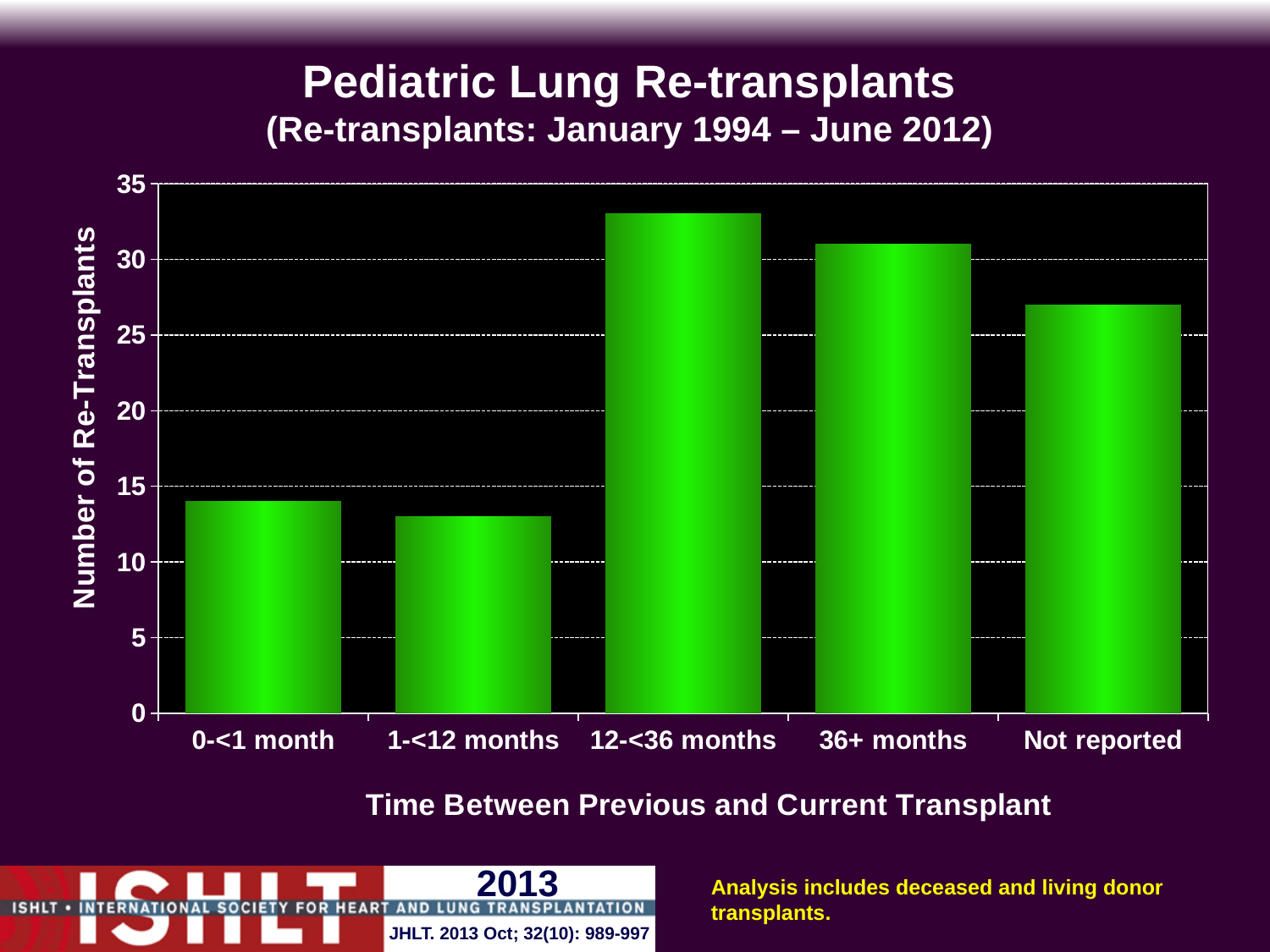
What type of chart is shown on the slide? bar chart Is the value for 0-<1 month greater or less than 10? greater What is the label of the y axis? Number of Re-Transplants Which is larger, the value for 12-<36 months or the value for Not reported? 12-<36 months Which is larger, the value for 36+ months or the value for 0-<1 month? 36+ months Which category has the highest number of re-transplants? 12-<36 months Is the value for Not reported greater or less than 30? less Is the value for 36+ months greater or less than 25? greater How many categories are shown on the x axis? 5 Which category has the lowest number of re-transplants? 1-<12 months